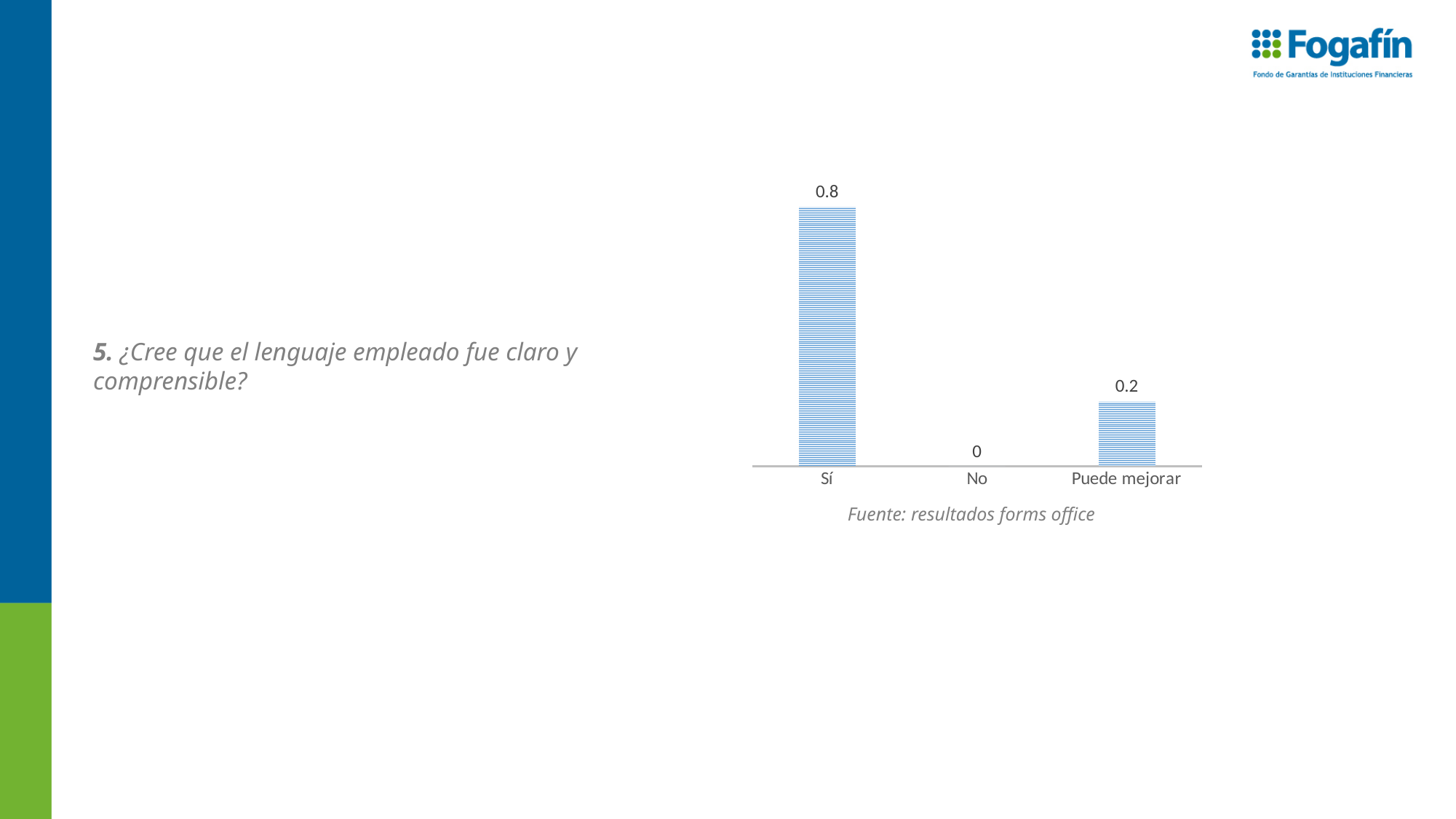
What source is cited below the chart? Fuente: resultados forms office Which is larger, the value for "Puede mejorar" or the value for "No"? Puede mejorar What is the value for "Puede mejorar"? 0.2 Which category has the highest value? Sí What survey question does the chart on the slide relate to? 5. ¿Cree que el lenguaje empleado fue claro y comprensible? Which category has the lowest value? No What is the difference between the values for "Sí" and "Puede mejorar"? 0.6 What kind of chart is shown on the slide? Bar chart What is the value for "No"? 0 How many categories are shown on the x axis? 3 What is the total of the three values shown in the chart? 1 What is the value for "Sí"? 0.8